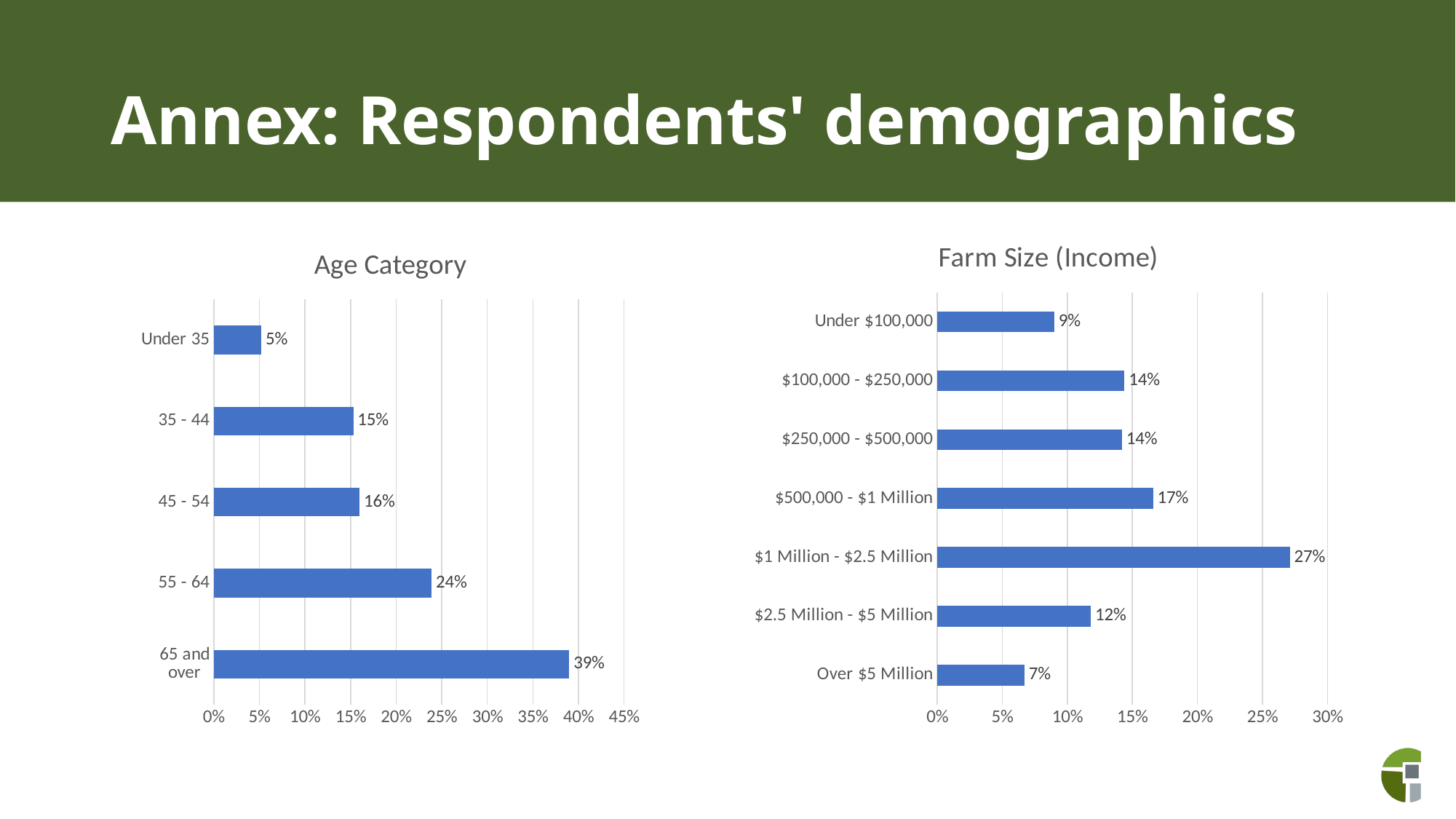
In the Farm Size (Income) chart, what is the value for $500,000 - $1 Million? 17% In the Farm Size (Income) chart, which farm size category has the lowest value? Over $5 Million In the Age Category chart, which age category has the lowest value? Under 35 In the Age Category chart, which age category has the highest value? 65 and over In the Age Category chart, what is the difference between the values for 65 and over and 55 - 64? 15% In the Age Category chart, what is the value for 55 - 64? 24% In the Farm Size (Income) chart, how many farm size categories are shown? 7 What kind of chart is the Age Category chart? Bar chart In the Age Category chart, how many age categories are shown? 5 In the Farm Size (Income) chart, which is larger: the value for Under $100,000 or the value for $2.5 Million - $5 Million? $2.5 Million - $5 Million In the Farm Size (Income) chart, which farm size category has the highest value? $1 Million - $2.5 Million In the Farm Size (Income) chart, what is the difference between the values for $1 Million - $2.5 Million and Over $5 Million? 20%